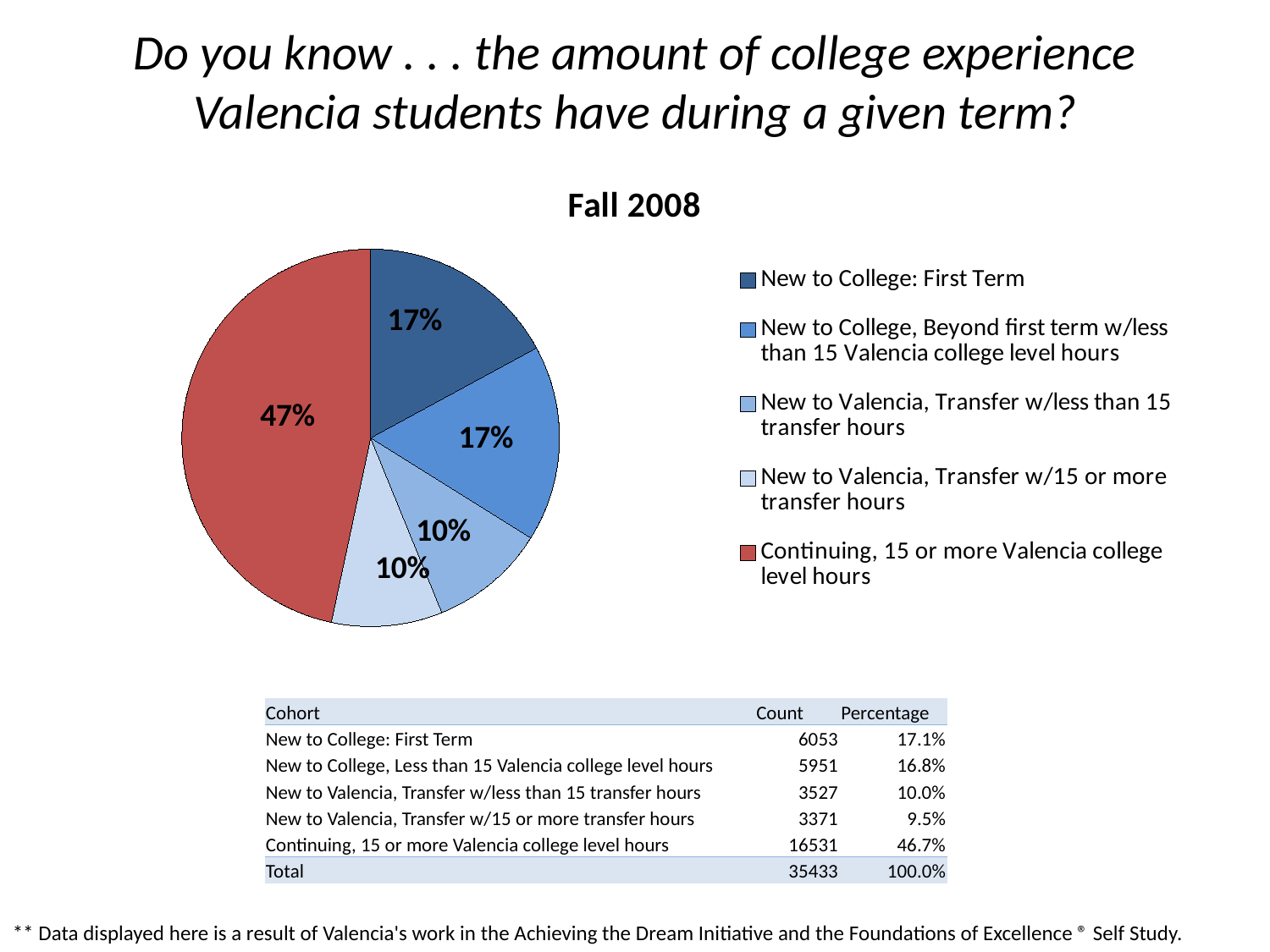
Which category has the largest slice of the pie? Continuing, 15 or more Valencia college level hours What is the title of the chart? Fall 2008 How many entries does the chart legend list? 5 What percentage of the pie is the 'New to Valencia, Transfer w/less than 15 transfer hours' slice? 10% What share of the pie do the 'New to Valencia, Transfer w/15 or more transfer hours' students represent? 10% How many slices does the pie chart have? 5 What kind of chart is shown on the slide? pie chart What percentage of the pie is the 'Continuing, 15 or more Valencia college level hours' slice? 47% What percentage of the pie is the 'New to College: First Term' slice? 17% Which colour represents 'Continuing, 15 or more Valencia college level hours' in the pie chart? red Which slice is larger: 'Continuing, 15 or more Valencia college level hours' or 'New to College: First Term'? Continuing, 15 or more Valencia college level hours What is the difference in percentage points between the 'Continuing, 15 or more Valencia college level hours' slice and the 'New to College: First Term' slice? 30%